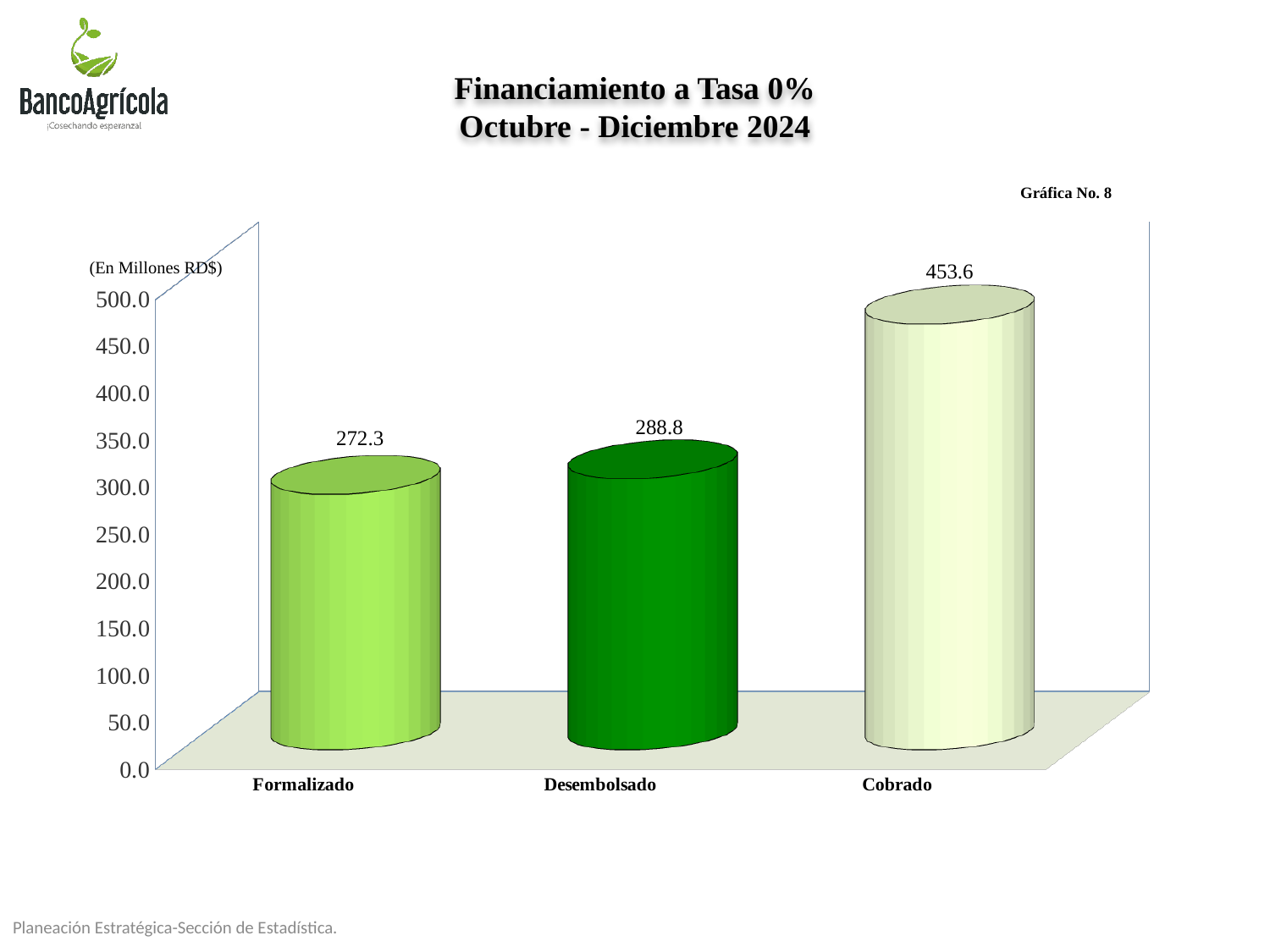
What is the title of the chart? Financiamiento a Tasa 0% Octubre - Diciembre 2024 How many categories are shown in the chart? 3 What kind of chart is shown on the slide? bar chart Which category has the lowest value? Formalizado What is the value for Desembolsado? 288.8 Which is larger, the value for Cobrado or the value for Desembolsado? Cobrado What is the difference between the values for Desembolsado and Formalizado? 16.5 Which category has the highest value? Cobrado Is the value for Cobrado greater or less than 400.0? greater What is the difference between the values for Cobrado and Formalizado? 181.3 What is the value for Formalizado? 272.3 What is the value for Cobrado? 453.6